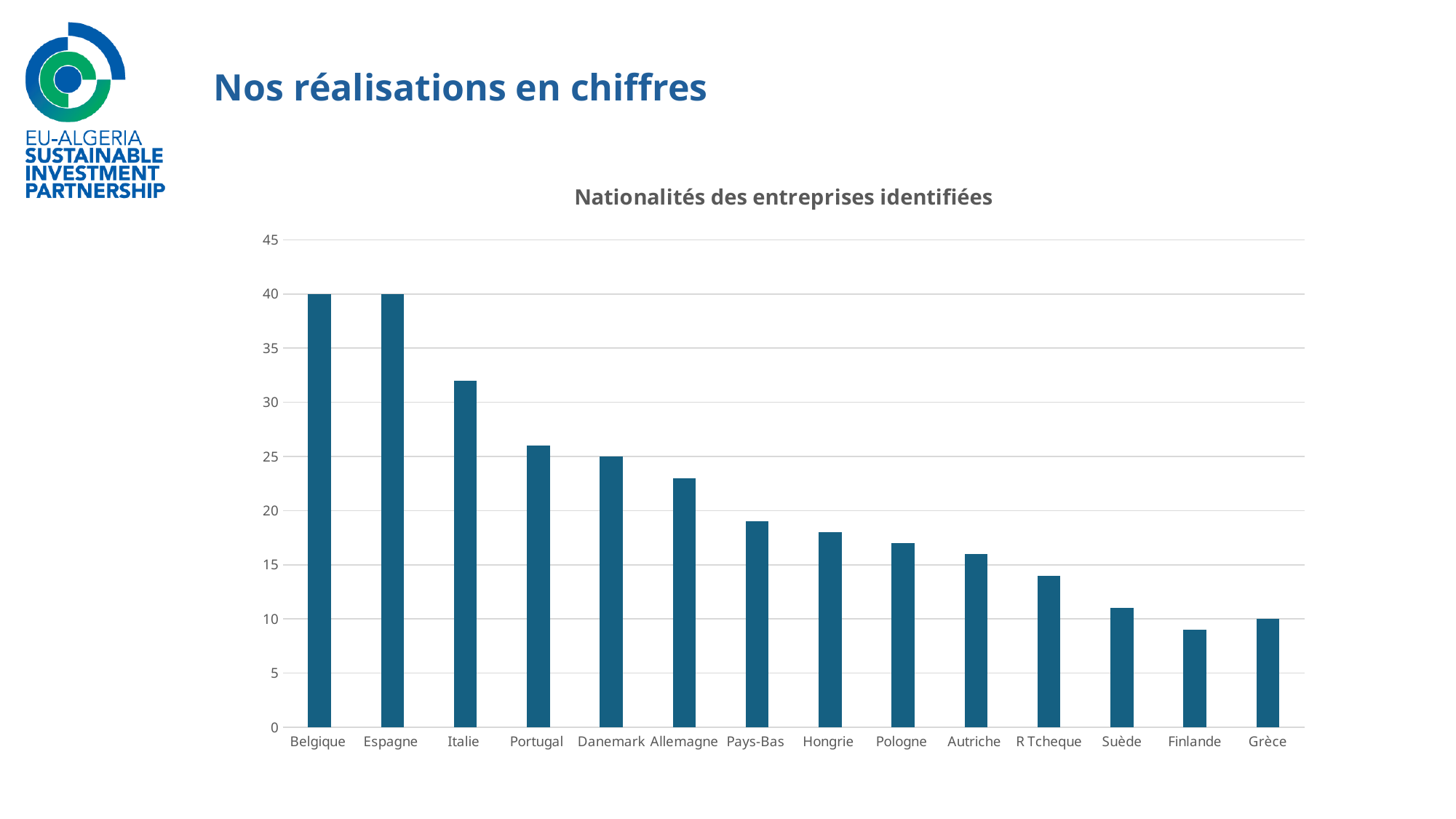
What is the title of the chart? Nationalités des entreprises identifiées What is the value for Danemark? 25 Which has a larger value, Italie or Portugal? Italie What type of chart is shown on the slide? bar chart What is the difference between the values for Belgique and Danemark? 15 Do the values generally rise or fall from left to right along the x axis? fall What is the value for Belgique? 40 Which country has the lowest value? Finlande Is the value for Pays-Bas greater or less than 20? less Is the value for Italie greater or less than 30? greater What is the value for Grèce? 10 How many countries are shown on the x axis of the chart? 14